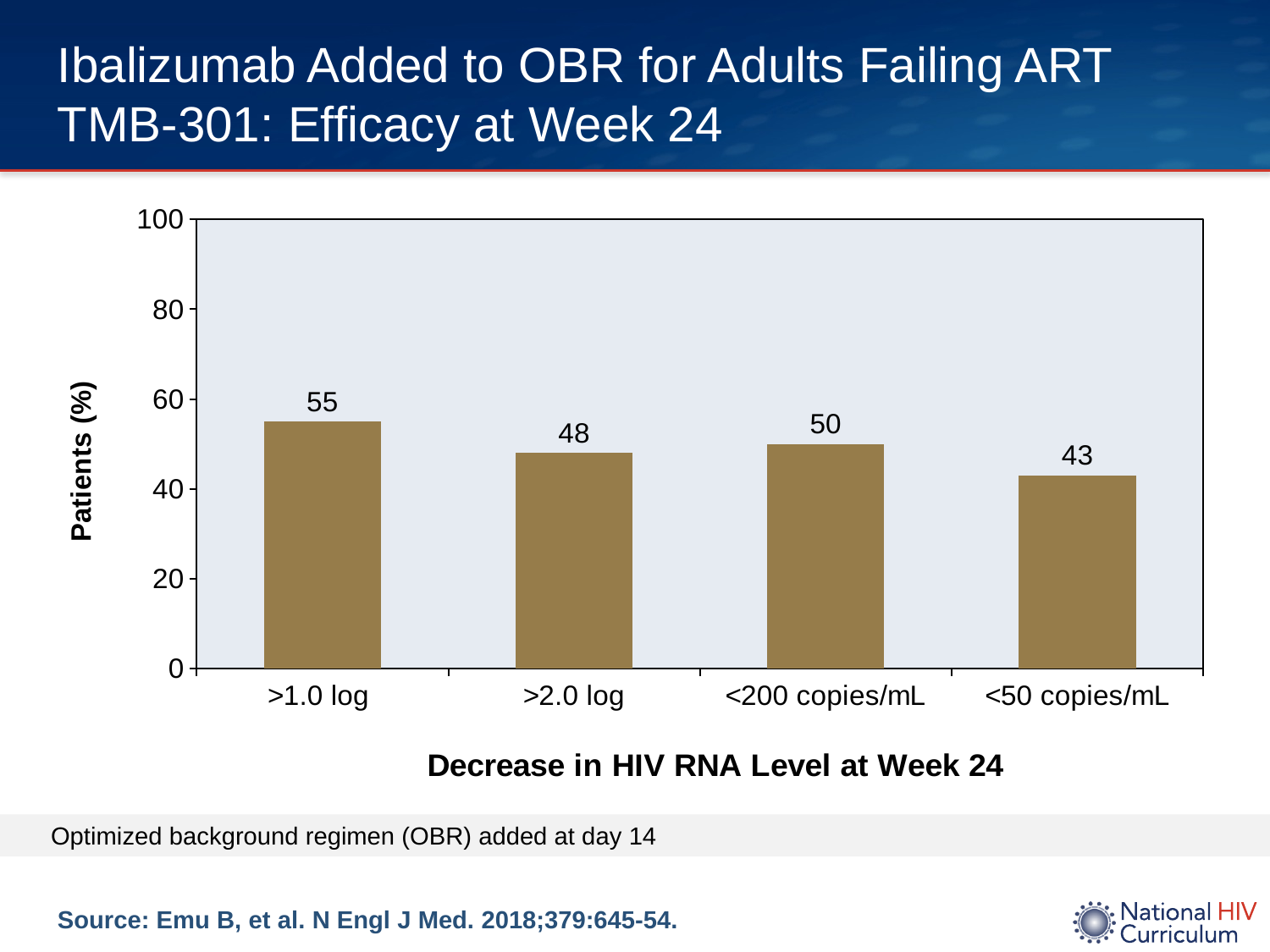
Which is larger: the percentage of patients with >2.0 log decrease or with <200 copies/mL? <200 copies/mL What is the label of the y axis? Patients (%) What percentage of patients had a >1.0 log decrease in HIV RNA level at week 24? 55 What is the difference in percentage of patients between >1.0 log and <50 copies/mL? 12 What percentage of patients reached <200 copies/mL at week 24? 50 Which category has the lowest percentage of patients? <50 copies/mL What percentage of patients had a >2.0 log decrease in HIV RNA level at week 24? 48 What percentage of patients reached <50 copies/mL at week 24? 43 How many categories are shown on the x axis? 4 Which category has the highest percentage of patients? >1.0 log What is the difference in percentage of patients between <200 copies/mL and >2.0 log? 2 What type of chart is shown on the slide? Bar chart